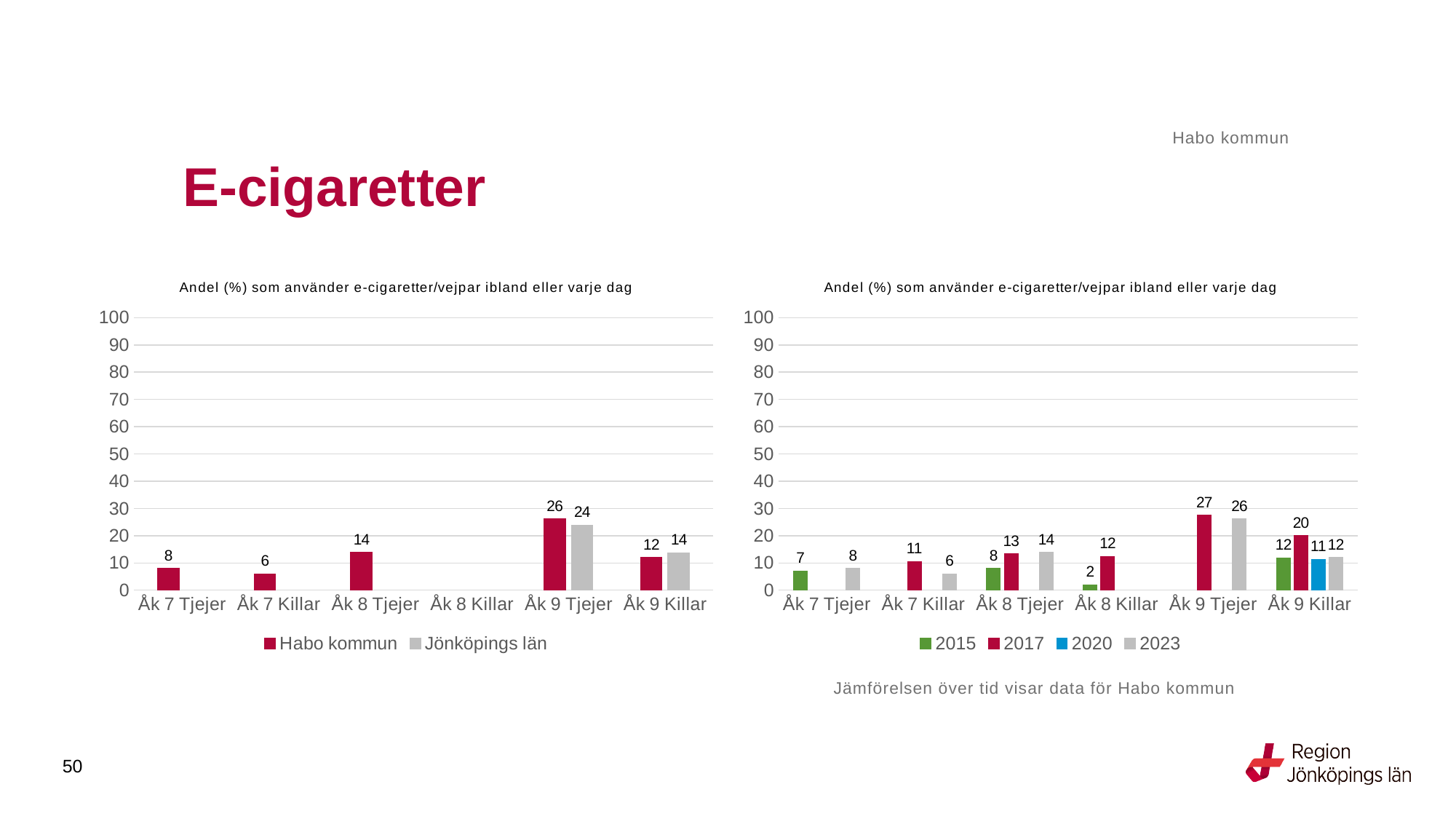
In the right chart, what is the value for 2015 for Åk 8 Killar? 2 In the left chart, what is the difference between Habo kommun and Jönköpings län for Åk 9 Tjejer? 2 In the right chart, what is the value for 2017 for Åk 9 Killar? 20 How many series does the legend of the right chart list? 4 What kind of chart is the right chart? Bar chart How many categories are shown on the x axis of the right chart? 6 In the left chart, which is larger for Åk 9 Killar: Habo kommun or Jönköpings län? Jönköpings län In the left chart, what is the value for Jönköpings län for Åk 9 Killar? 14 In the right chart, what is the difference between 2017 and 2023 for Åk 7 Killar? 5 In the left chart, which category has the highest value for Habo kommun? Åk 9 Tjejer In the left chart, what is the value for Habo kommun for Åk 9 Tjejer? 26 How many series does the legend of the left chart list? 2